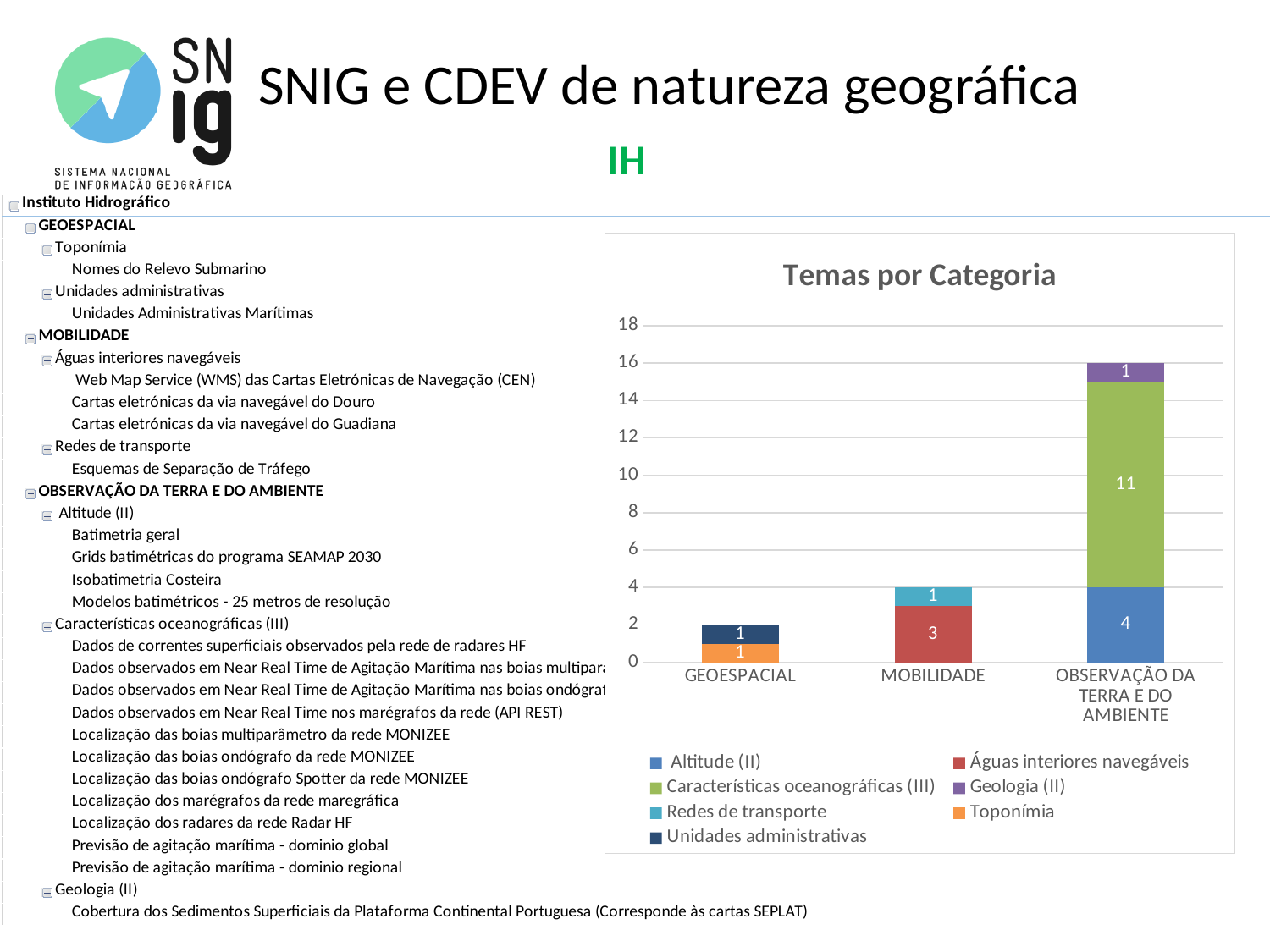
What is the difference between the Características oceanográficas (III) value and the Altitude (II) value for OBSERVAÇÃO DA TERRA E DO AMBIENTE? 7 What type of chart is shown on the slide? stacked bar chart What is the title of the chart? Temas por Categoria How many categories are shown on the x axis of the chart? 3 Which category has the highest total bar? OBSERVAÇÃO DA TERRA E DO AMBIENTE What is the value of Características oceanográficas (III) for OBSERVAÇÃO DA TERRA E DO AMBIENTE? 11 How many series does the chart legend list? 7 What is the total of the stacked bar for MOBILIDADE? 4 What is the value of Altitude (II) for OBSERVAÇÃO DA TERRA E DO AMBIENTE? 4 Which category has the lowest total bar? GEOESPACIAL What is the total of the stacked bar for OBSERVAÇÃO DA TERRA E DO AMBIENTE? 16 What is the value of Águas interiores navegáveis for MOBILIDADE? 3